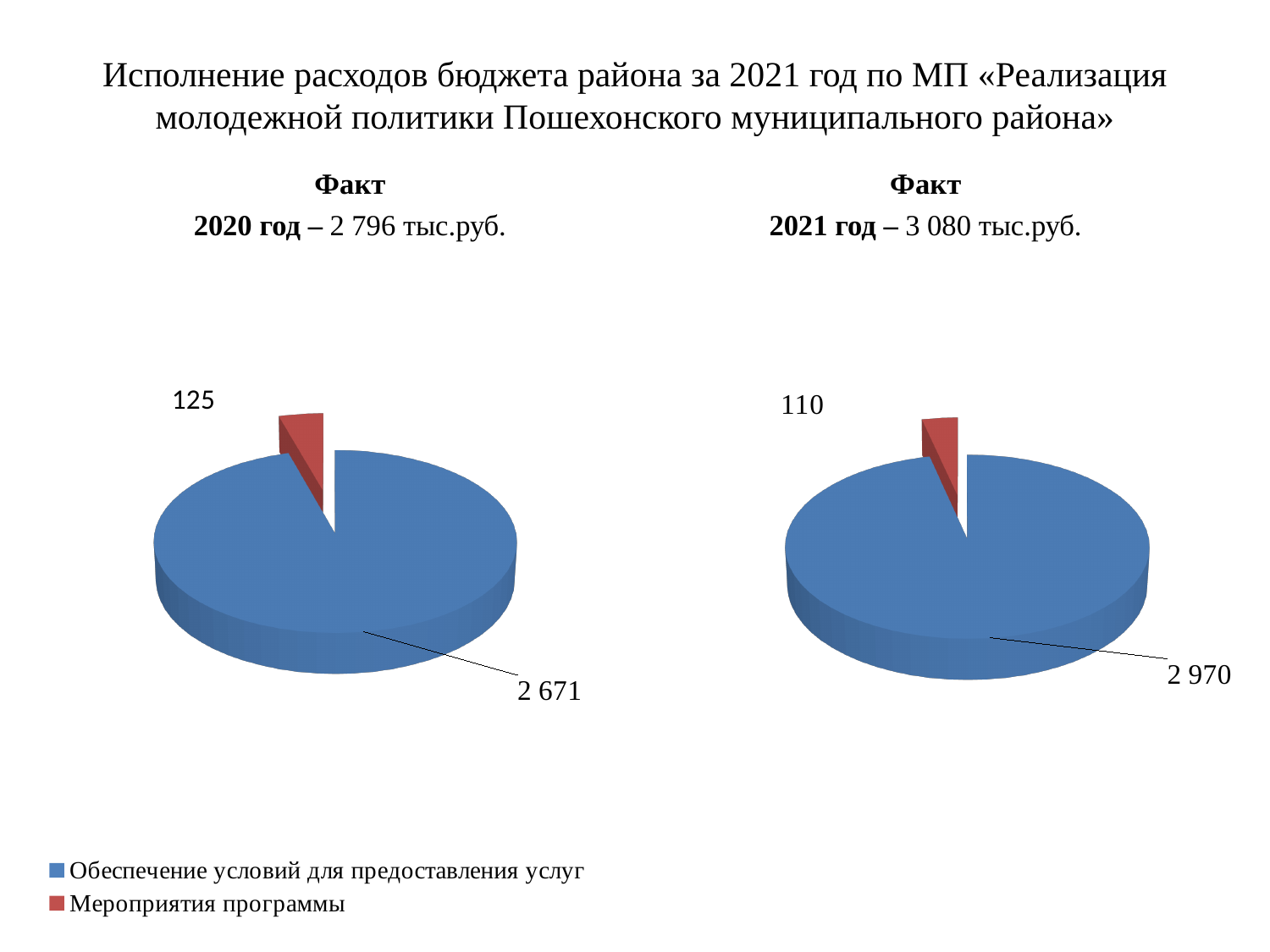
How many series does the legend list? 2 What is the difference between the Мероприятия программы value in the 2020 chart and in the 2021 chart? 15 In the left pie chart (2020), which category has the largest slice? Обеспечение условий для предоставления услуг What type of chart is used on this slide? Pie chart In the left pie chart (2020), what is the value for Мероприятия программы? 125 In the left pie chart (2020), what is the difference between the two slice values? 2 546 Is the Обеспечение условий для предоставления услуг value larger in the 2020 chart or the 2021 chart? 2021 In the right pie chart (2021), what is the value for Обеспечение условий для предоставления услуг? 2 970 In the right pie chart (2021), which category has the smallest slice? Мероприятия программы In the left pie chart (2020), what is the value for Обеспечение условий для предоставления услуг? 2 671 In the right pie chart (2021), what is the value for Мероприятия программы? 110 How many slices does each pie chart have? 2